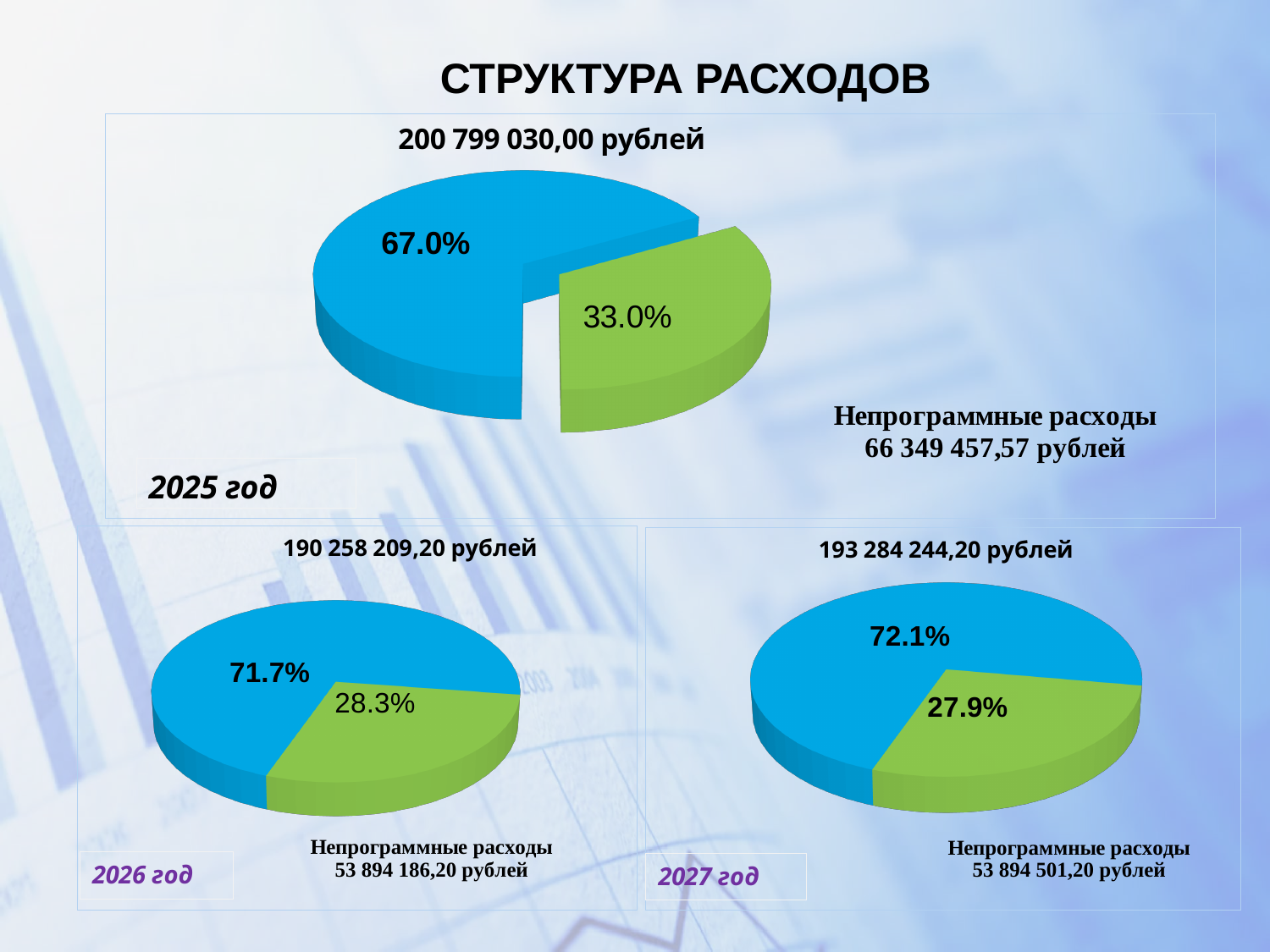
What amount of Непрограммные расходы is shown for the 2027 год pie chart? 53 894 501,20 рублей In the 2025 год pie chart, what share does the blue slice represent? 67.0% In the 2025 год pie chart, what share does the green slice represent? 33.0% What total amount in rubles is shown above the 2026 год pie chart? 190 258 209,20 рублей How many slices does the 2025 год pie chart have? 2 In the 2027 год pie chart, what share does the blue slice represent? 72.1% In the 2025 год pie chart, which slice is larger, the blue one or the green one? the blue one In the 2027 год pie chart, what share does the green slice represent? 27.9% In the 2027 год pie chart, what is the difference in percentage points between the blue slice and the green slice? 44.2 In the 2026 год pie chart, what share does the green slice represent? 28.3% What kind of chart is used for the 2025 год data? pie chart In the 2026 год pie chart, what share does the blue slice represent? 71.7%